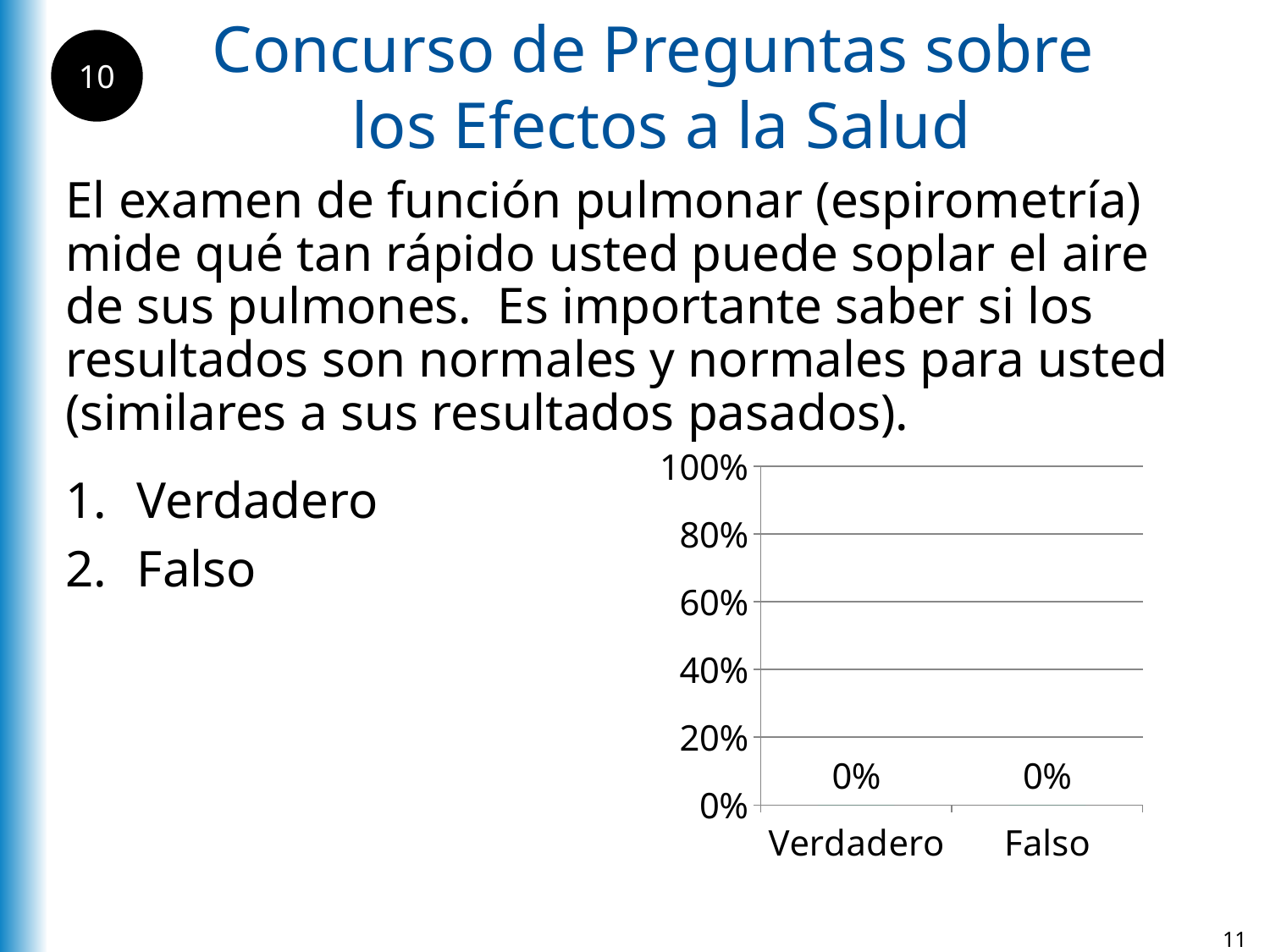
How many categories are shown on the x axis of the chart? 2 Is the value for Falso greater or less than 20%? less What is the value shown for Falso in the chart? 0% What kind of chart is shown on the slide? bar chart What is the difference between the values for Verdadero and Falso? 0% Is the value for Verdadero greater or less than 20%? less What is the highest value labelled on the chart's vertical axis? 100% What are the two category labels on the x axis of the chart? Verdadero and Falso What is the value shown for Verdadero in the chart? 0%